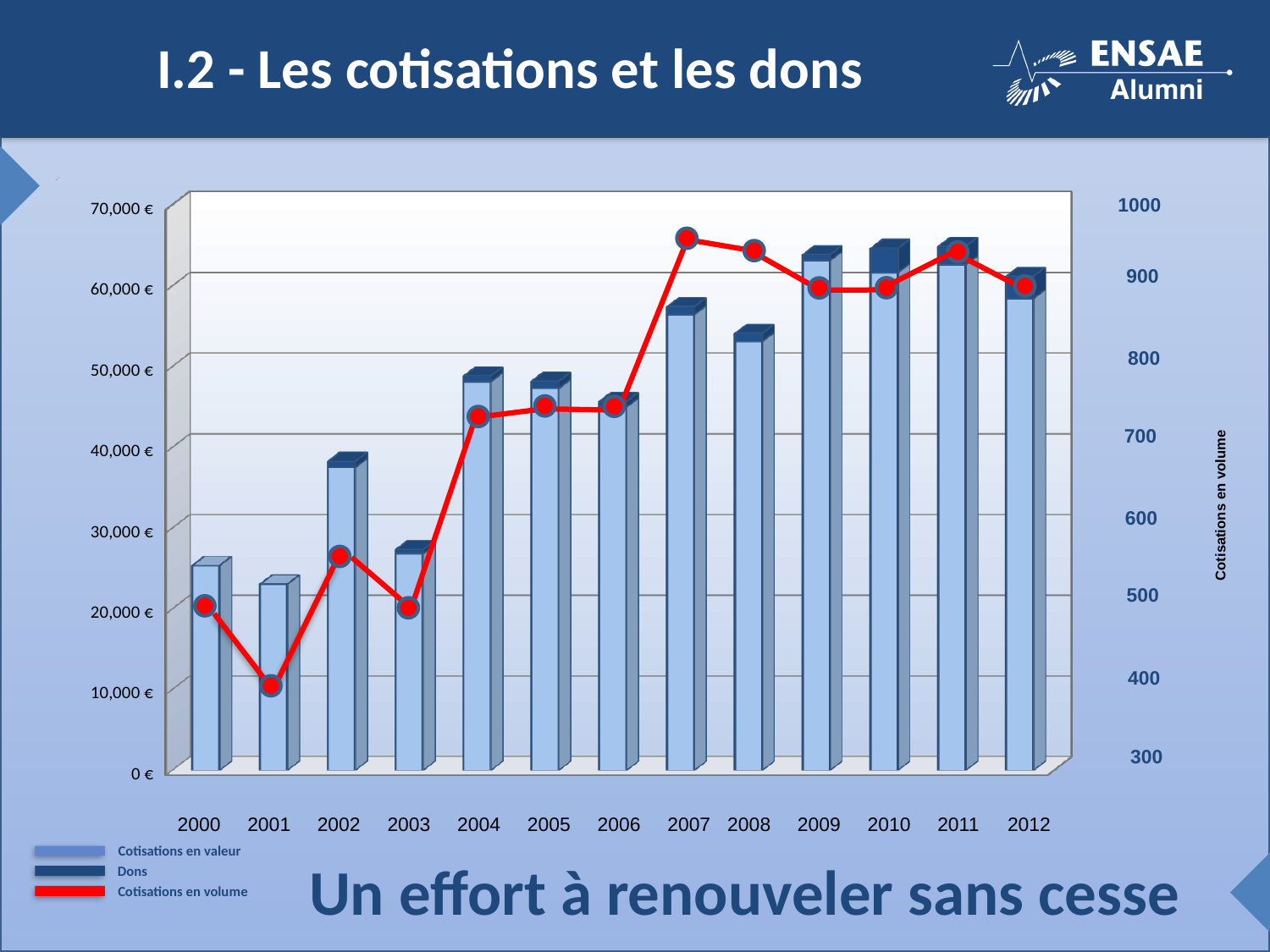
How many years are shown on the x axis of the chart? 13 What kind of chart is shown on the slide? bar chart with a line How many series does the chart legend list? 3 In which year does the Cotisations en volume line reach its lowest point? 2001 Which year has the taller Cotisations en valeur bar, 2002 or 2003? 2002 Is the Cotisations en valeur bar for 2001 greater or less than 30,000 €? less What is the title of the right-hand vertical axis? Cotisations en volume Which year has the lowest bar for Cotisations en valeur? 2001 Does the Cotisations en volume line rise or fall from 2003 to 2007? rise Is the Cotisations en valeur bar for 2007 greater or less than 50,000 €? greater In which year does the Cotisations en volume line reach its highest point? 2007 Is the Cotisations en volume value for 2007 greater or less than 900? greater